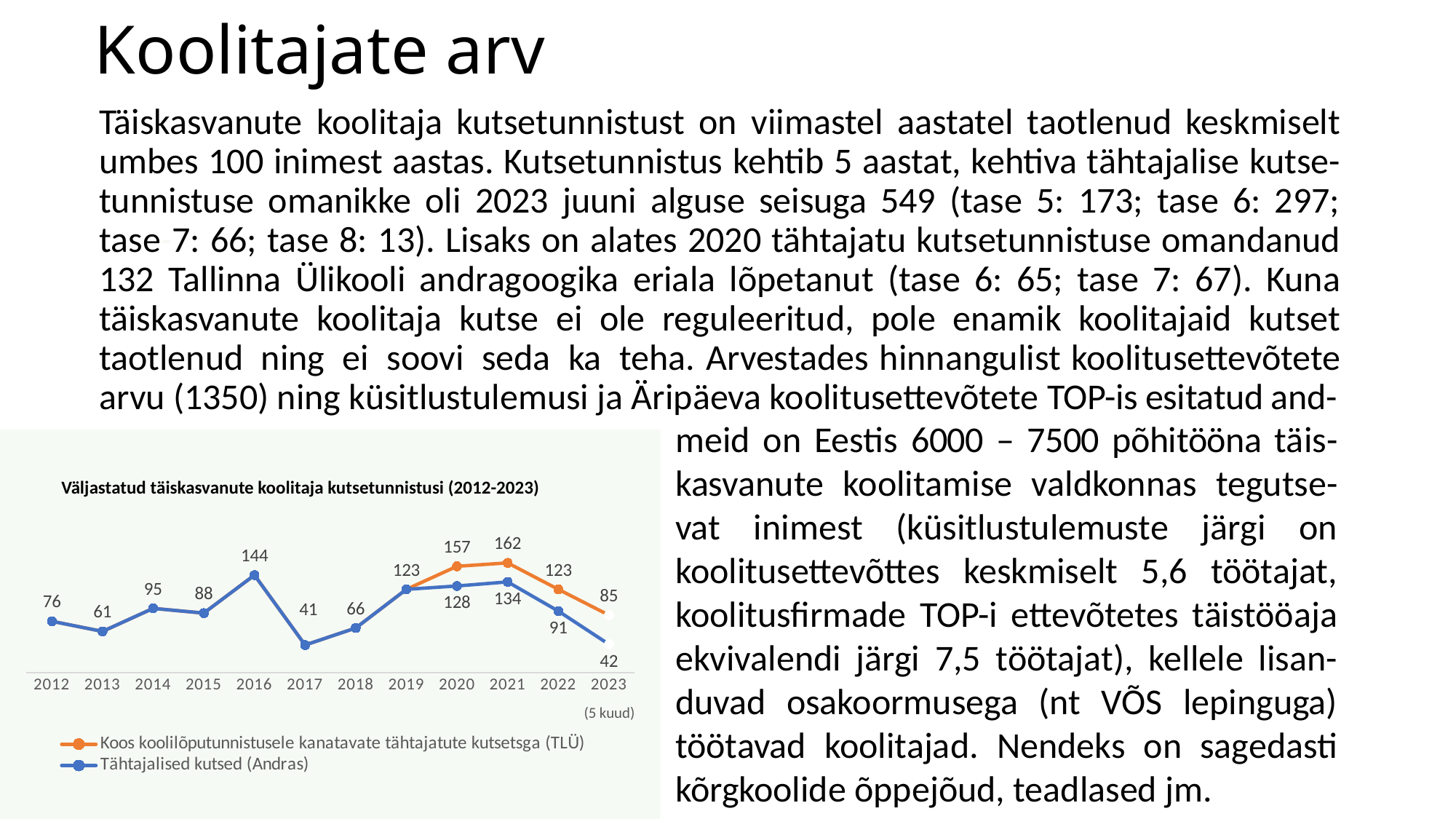
Which is larger: the Andras series value for 2014 or for 2015? 2014 What is the value of the Tähtajalised kutsed (Andras) series for 2016? 144 How many series does the chart legend list? 2 In which year does the Tähtajalised kutsed (Andras) series reach its highest value? 2016 What is the value of the Koos koolilõputunnistusele kanatavate tähtajatute kutsetsga (TLÜ) series for 2021? 162 What is the difference between the TLÜ series and the Andras series in 2020? 29 How many years are shown on the x axis of the chart? 12 What type of chart is shown on the slide? line chart What is the title of the chart? Väljastatud täiskasvanute koolitaja kutsetunnistusi (2012-2023) Does the Tähtajalised kutsed (Andras) series rise or fall from 2021 to 2023? fall What is the value of the Tähtajalised kutsed (Andras) series for 2023? 42 In which year does the Tähtajalised kutsed (Andras) series have its lowest value? 2017